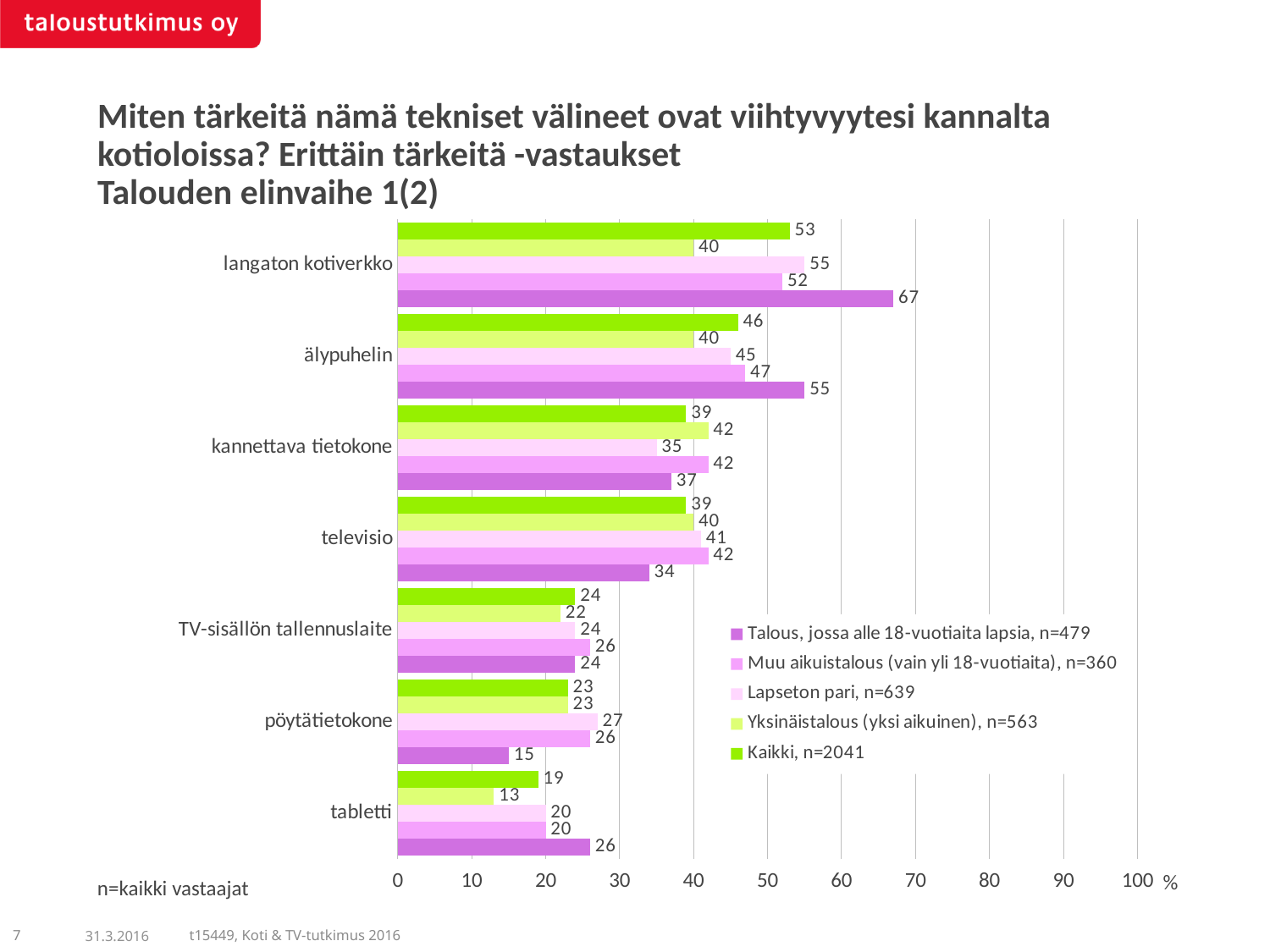
What is the value for 'pöytätietokone' in the 'Lapseton pari, n=639' series? 27 What is the value for 'älypuhelin' in the 'Kaikki, n=2041' series? 46 For 'televisio', which is larger: the 'Muu aikuistalous (vain yli 18-vuotiaita), n=360' value or the 'Talous, jossa alle 18-vuotiaita lapsia, n=479' value? Muu aikuistalous (vain yli 18-vuotiaita), n=360 Is the value for 'älypuhelin' in the 'Talous, jossa alle 18-vuotiaita lapsia, n=479' series greater or less than 50? greater What kind of chart is shown on the slide? bar chart Which category has the highest value in the 'Kaikki, n=2041' series? langaton kotiverkko What is the value for 'langaton kotiverkko' in the 'Talous, jossa alle 18-vuotiaita lapsia, n=479' series? 67 What is the difference between the 'Talous, jossa alle 18-vuotiaita lapsia, n=479' and 'Yksinäistalous (yksi aikuinen), n=563' values for 'langaton kotiverkko'? 27 What is the value for 'tabletti' in the 'Yksinäistalous (yksi aikuinen), n=563' series? 13 How many series does the legend list? 5 How many categories are shown on the chart? 7 Which category has the lowest value in the 'Talous, jossa alle 18-vuotiaita lapsia, n=479' series? pöytätietokone